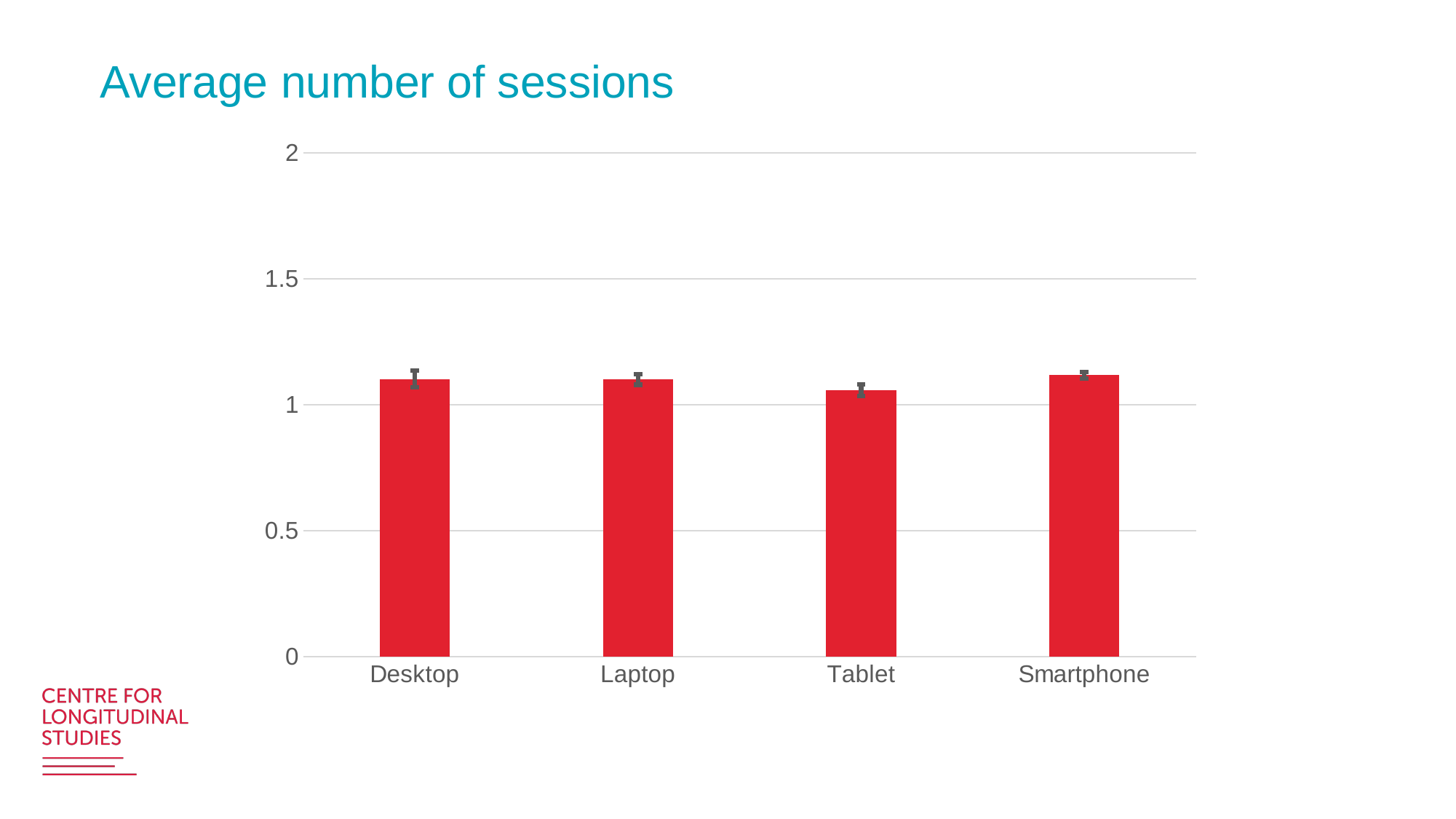
Is the value for Tablet greater or less than 1? greater Which category has the lowest average number of sessions? Tablet What is the title of the chart on the slide? Average number of sessions What kind of chart is shown on the slide? bar chart How many categories are shown on the x axis of the chart? 4 What is the highest value shown on the y axis of the chart? 2 What colour are the bars in the chart? red Is the value for Desktop greater or less than 1? greater Is the value for Laptop greater or less than 1.5? less